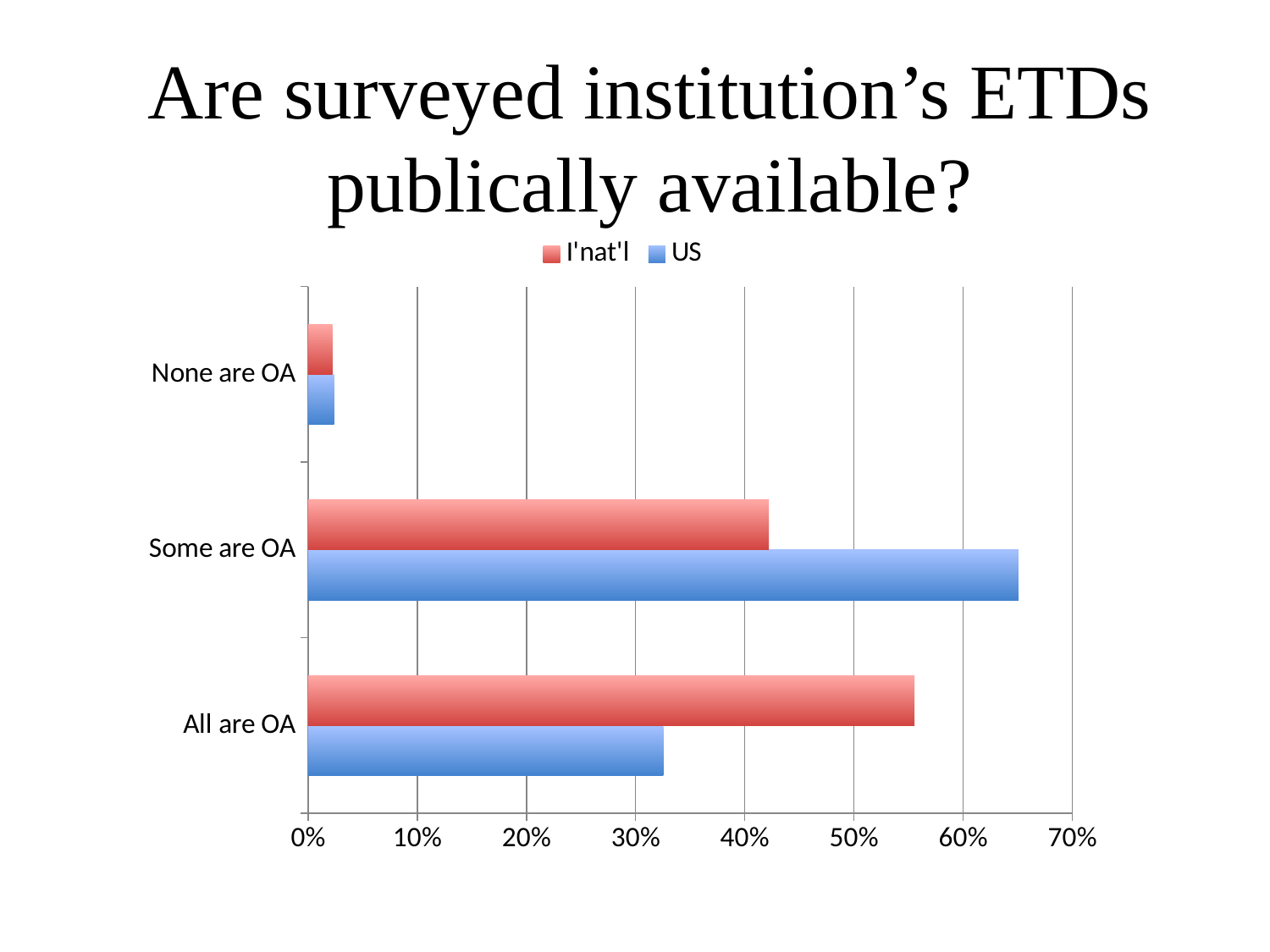
How many categories are shown on the chart? 3 How many series does the legend list? 2 Which category has the lowest value for the US series? None are OA Is the US value for 'Some are OA' greater or less than 60%? greater Which colour represents the US series in the legend? blue Which category has the highest value for the I'nat'l series? All are OA Which category has the lowest value for the I'nat'l series? None are OA What kind of chart is shown on the slide? bar chart Which category has the highest value for the US series? Some are OA Is the I'nat'l value for 'All are OA' greater or less than 50%? greater For 'Some are OA', which series has the larger value, I'nat'l or US? US For 'All are OA', which series has the larger value, I'nat'l or US? I'nat'l